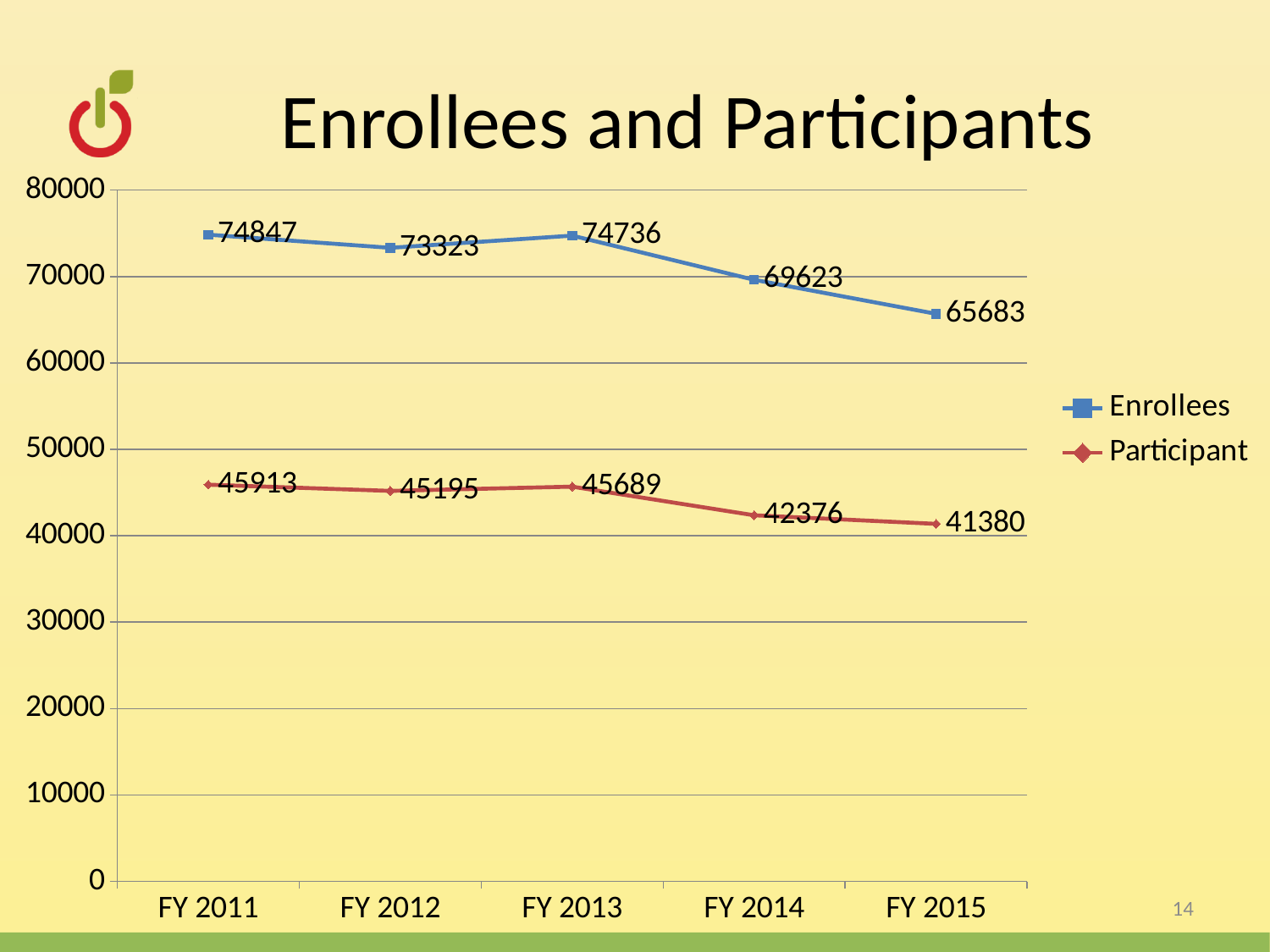
In which fiscal year is the number of Enrollees highest? FY 2011 Is the number of Enrollees in FY 2015 greater or less than 70000? less By how much did the number of Enrollees fall from FY 2011 to FY 2015? 9164 Which is larger: Participants in FY 2011 or Participants in FY 2013? Participants in FY 2011 What kind of chart is shown on the slide? line chart How many series does the legend list? 2 What is the number of Enrollees in FY 2013? 74736 What is the number of Participants in FY 2012? 45195 How many fiscal years are shown on the x axis? 5 In which fiscal year is the number of Participants lowest? FY 2015 What is the number of Participants in FY 2015? 41380 What is the difference between Enrollees and Participants in FY 2014? 27247